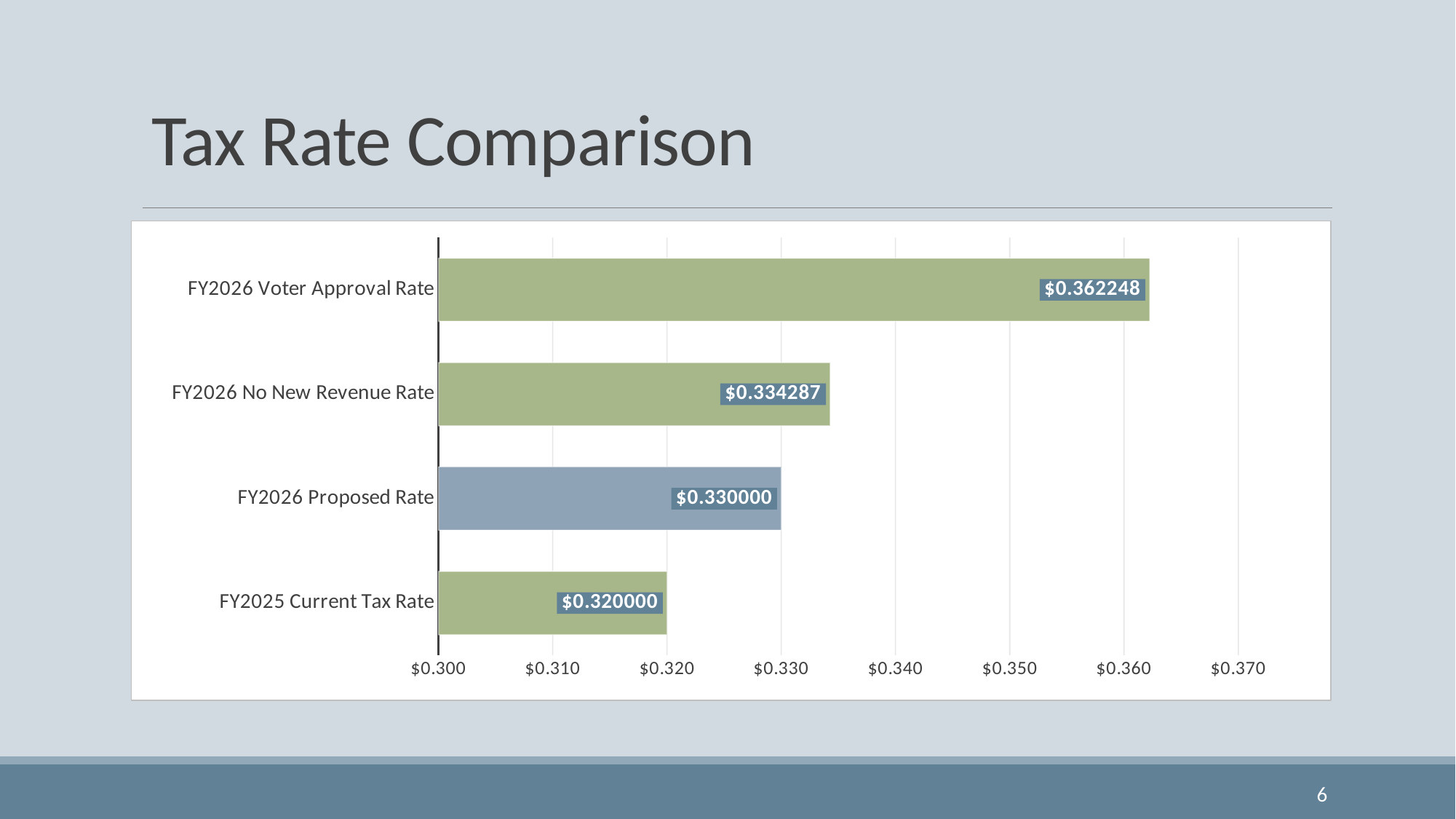
What is the difference between the FY2026 Voter Approval Rate and the FY2026 No New Revenue Rate? $0.027961 Is the value for FY2026 Voter Approval Rate greater or less than $0.350? greater Which category has the lowest value? FY2025 Current Tax Rate What kind of chart is shown on the slide? Bar chart What is the value for FY2026 Voter Approval Rate? $0.362248 Which is larger, the FY2026 No New Revenue Rate or the FY2026 Proposed Rate? FY2026 No New Revenue Rate What is the difference between the FY2026 Proposed Rate and the FY2025 Current Tax Rate? $0.010000 What is the value for FY2025 Current Tax Rate? $0.320000 What is the value for FY2026 No New Revenue Rate? $0.334287 Which category has the highest value? FY2026 Voter Approval Rate What is the value for FY2026 Proposed Rate? $0.330000 How many categories are shown in the chart? 4